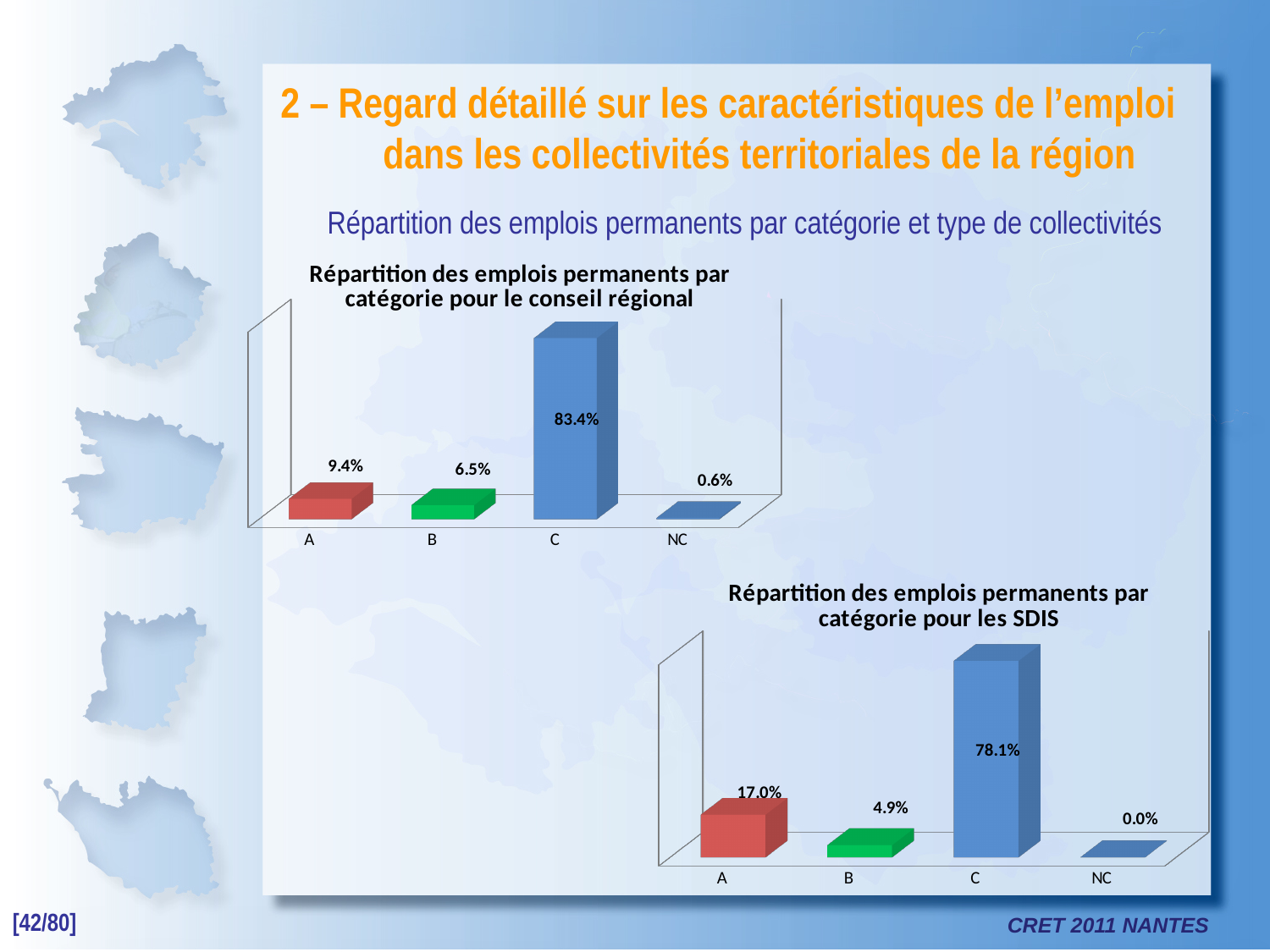
In the chart 'Répartition des emplois permanents par catégorie pour les SDIS', which category has the lowest value? NC How many categories are shown in the chart 'Répartition des emplois permanents par catégorie pour le conseil régional'? 4 In the chart 'Répartition des emplois permanents par catégorie pour le conseil régional', what is the value for category C? 83.4% What kind of chart is 'Répartition des emplois permanents par catégorie pour les SDIS'? Bar chart In the chart 'Répartition des emplois permanents par catégorie pour les SDIS', which is larger, the value for A or the value for B? A In the chart 'Répartition des emplois permanents par catégorie pour les SDIS', what is the value for category B? 4.9% In the chart 'Répartition des emplois permanents par catégorie pour le conseil régional', what colour is the bar for category B? Green In the chart 'Répartition des emplois permanents par catégorie pour le conseil régional', which category has the highest value? C In the chart 'Répartition des emplois permanents par catégorie pour les SDIS', what is the value for NC? 0.0% In the chart 'Répartition des emplois permanents par catégorie pour le conseil régional', what is the difference between the values for A and B? 2.9% In the chart 'Répartition des emplois permanents par catégorie pour le conseil régional', what is the value for category A? 9.4% In the chart 'Répartition des emplois permanents par catégorie pour les SDIS', what is the difference between the values for C and A? 61.1%